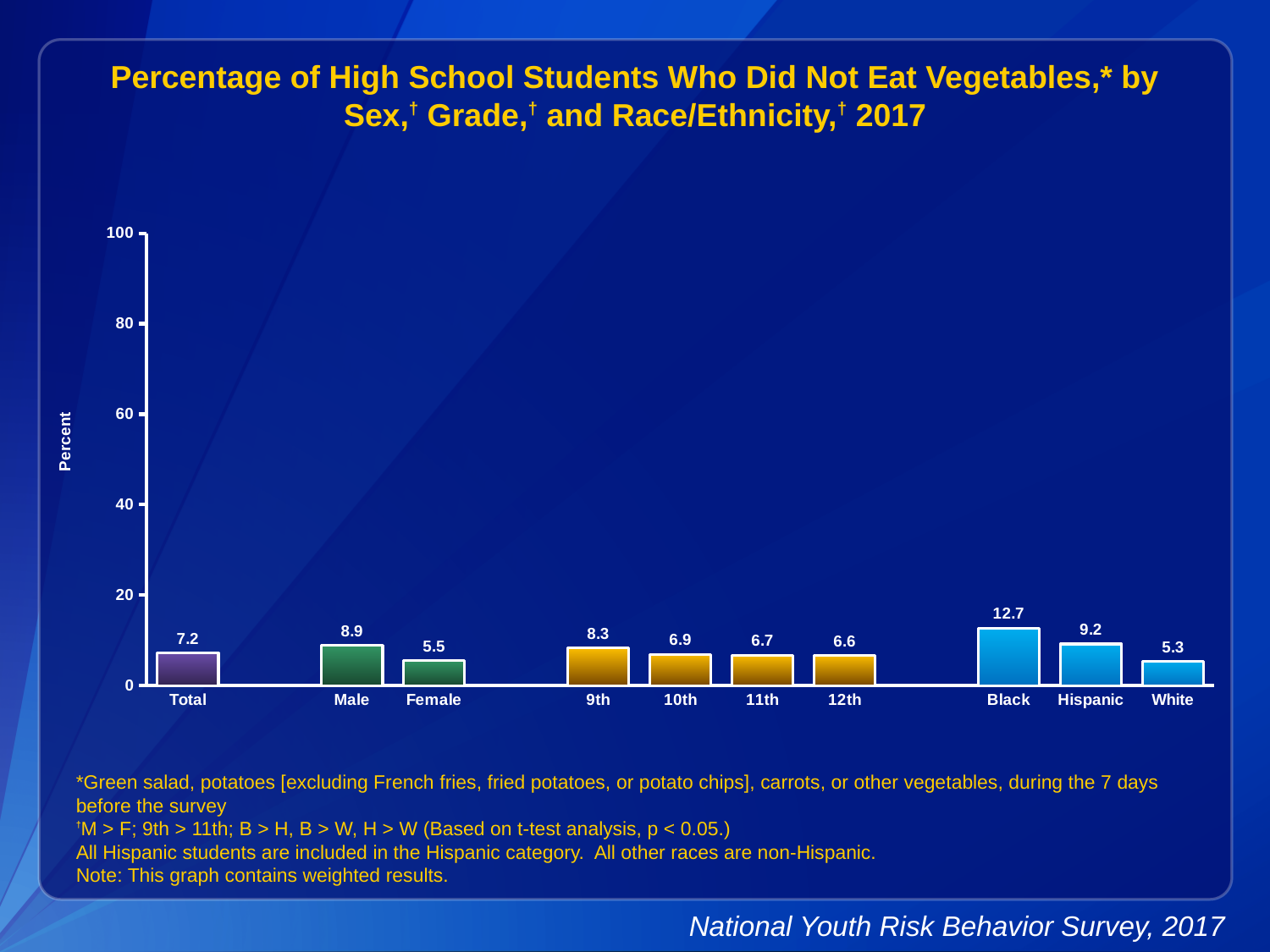
What is the difference between the values for Male and Female? 3.4 What is the value for Male? 8.9 Is the value for Black greater or less than 20? less Which is larger, the value for 9th or the value for 12th? 9th What is the value for Hispanic? 9.2 Do the values rise or fall from 9th grade to 12th grade? fall Which category has the highest value? Black What is the difference between the values for Black and White? 7.4 What is the value for Total? 7.2 How many categories are shown on the x axis? 10 What kind of chart is this? bar chart Which category has the lowest value? White